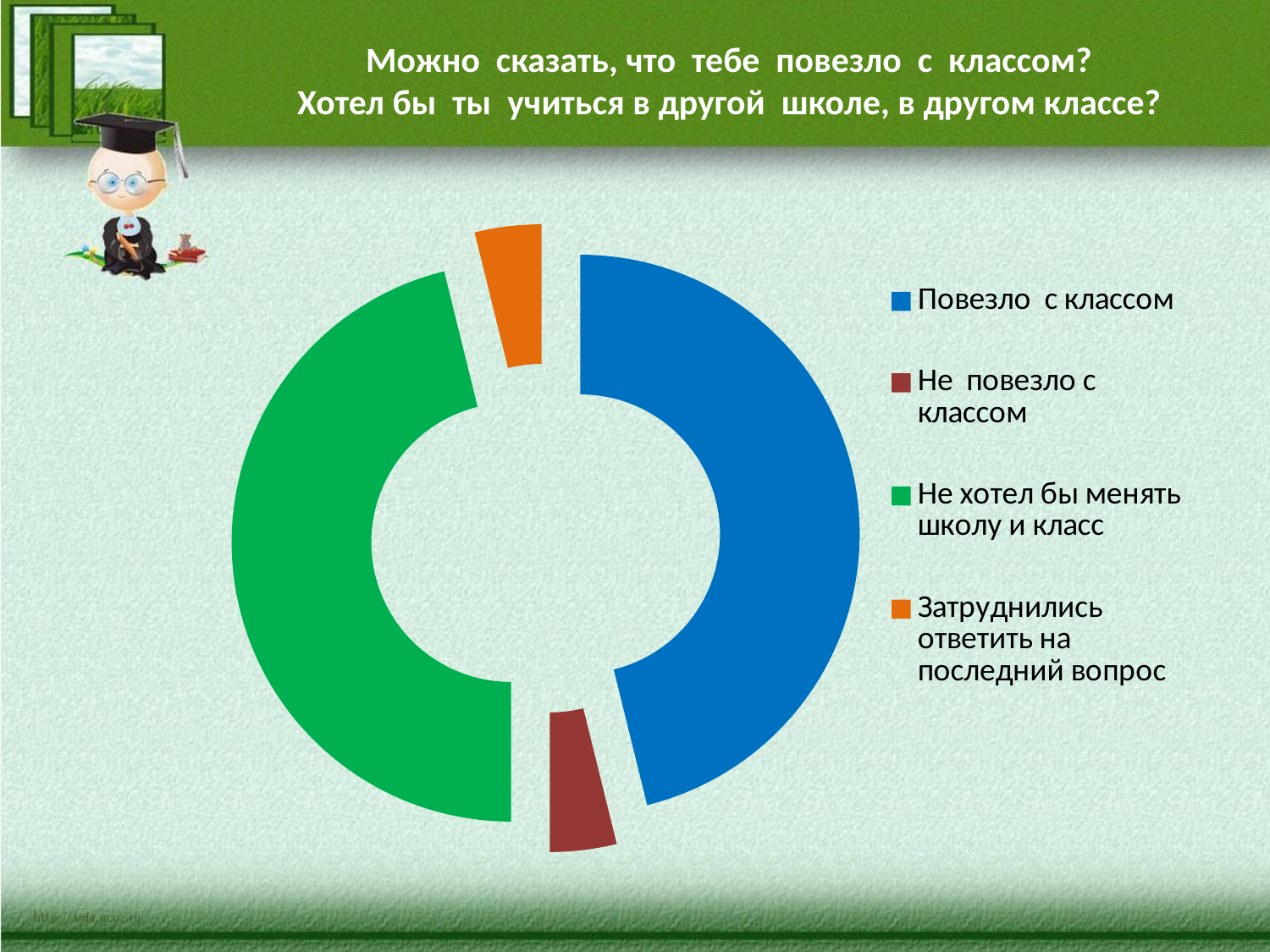
Which colour represents "Затруднились ответить на последний вопрос" in the chart? orange Which category is shown in blue in the chart? Повезло с классом How many categories does the chart's legend list? 4 Which is larger, the slice for "Не хотел бы менять школу и класс" or the slice for "Не повезло с классом"? Не хотел бы менять школу и класс What kind of chart is shown on the slide? doughnut chart Which is larger, the slice for "Повезло с классом" or the slice for "Не повезло с классом"? Повезло с классом Which is larger, the slice for "Повезло с классом" or the slice for "Затруднились ответить на последний вопрос"? Повезло с классом